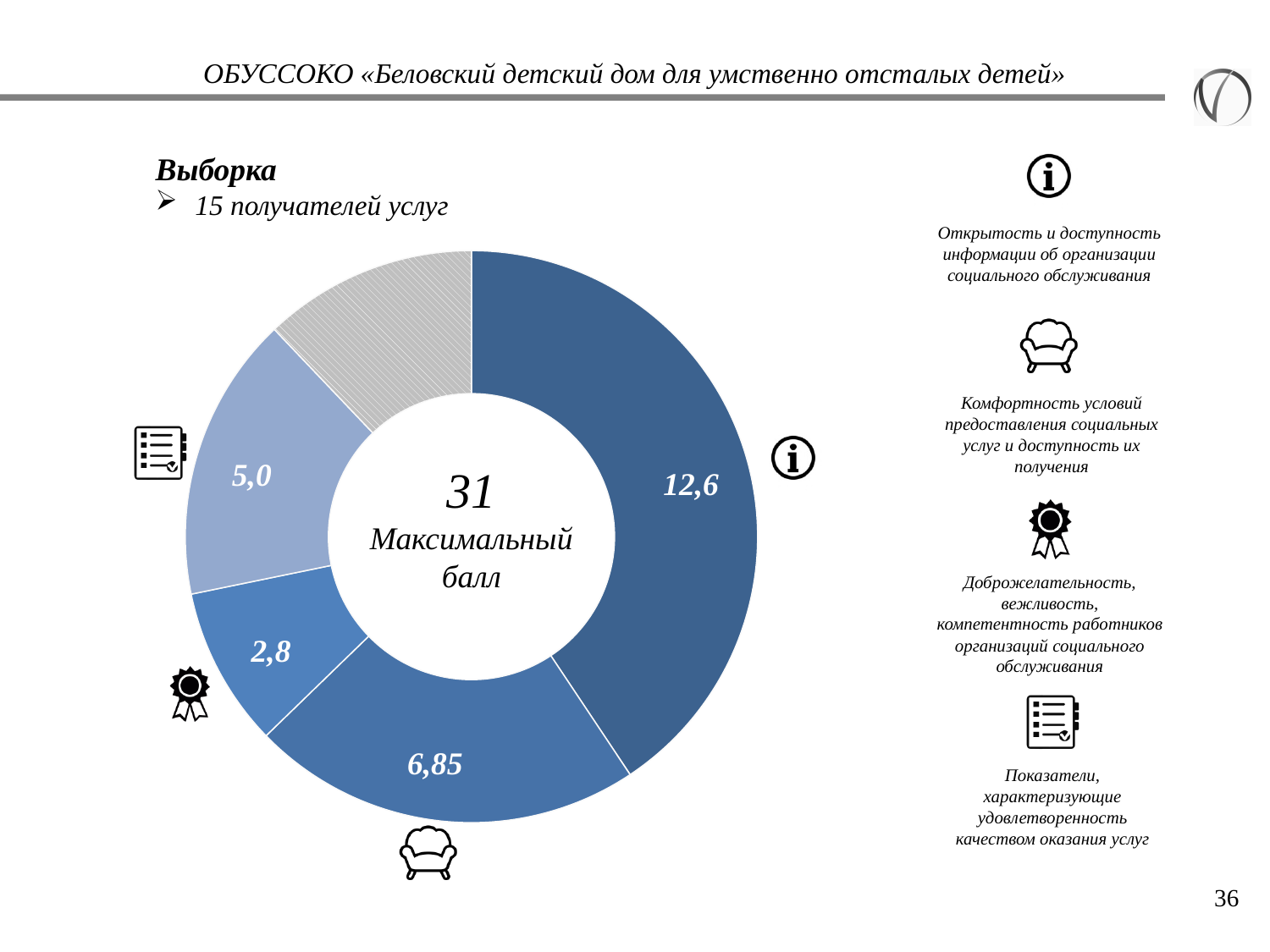
What kind of chart is shown on the slide? Donut (pie) chart What is the difference between the checklist-icon segment (5,0) and the medal-icon segment (2,8)? 2,2 Which labelled segment of the donut chart has the highest value? 12,6 (Открытость и доступность информации) What value is shown for the segment marked with the checklist icon (Показатели, характеризующие удовлетворенность)? 5,0 What value is shown for the segment marked with the medal icon (Доброжелательность, вежливость, компетентность работников)? 2,8 Which labelled segment of the donut chart has the lowest value? 2,8 (Доброжелательность, вежливость, компетентность работников) How many segments of the donut chart have a printed value label? 4 Which is larger: the value for the armchair-icon segment or the checklist-icon segment? Armchair-icon segment (6,85) What value is shown for the segment marked with the information icon (Открытость и доступность информации)? 12,6 What value is shown for the segment marked with the armchair icon (Комфортность условий)? 6,85 What is the difference between the information-icon segment (12,6) and the armchair-icon segment (6,85)? 5,75 What maximum score is printed in the centre of the donut chart? 31